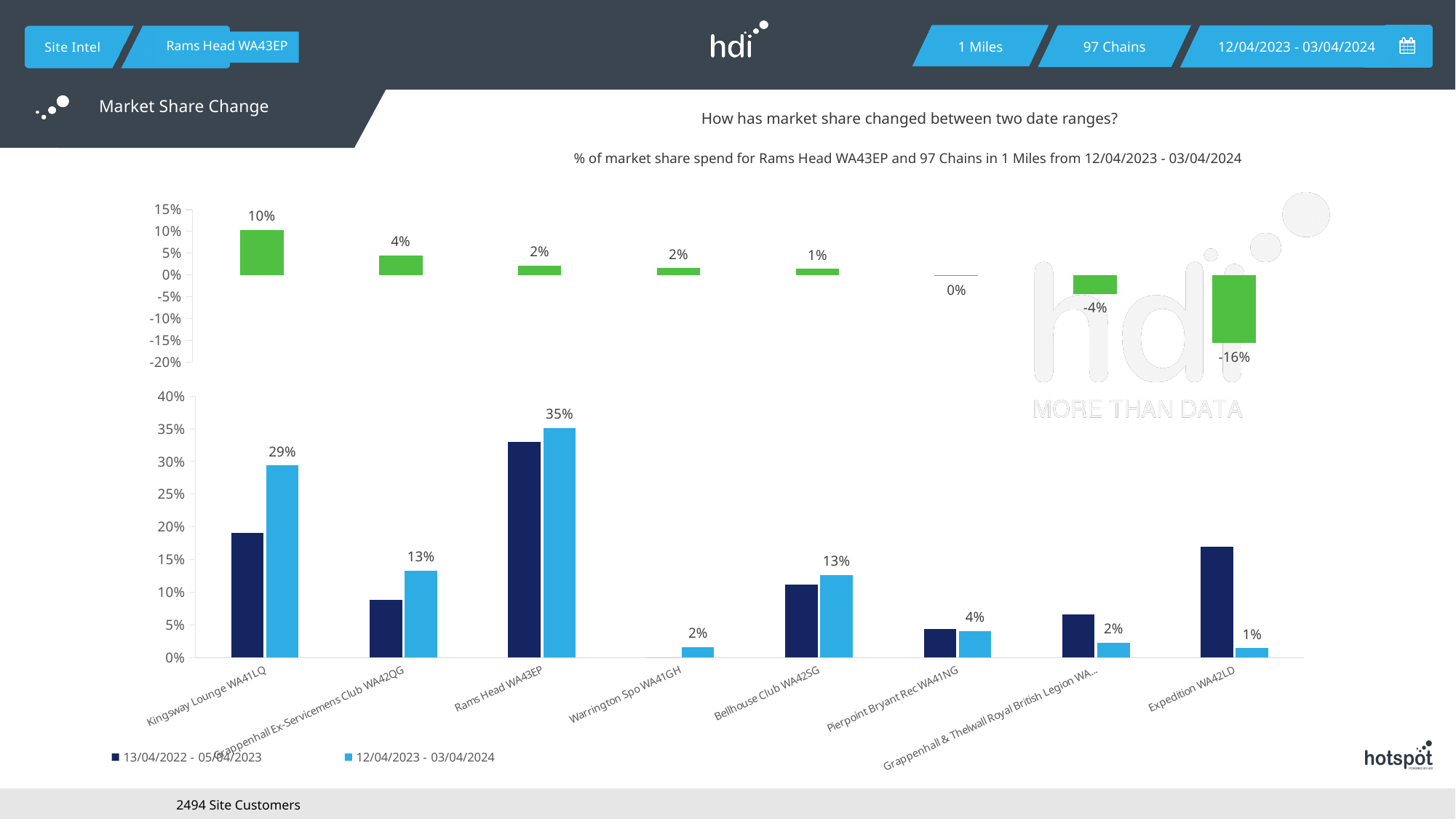
In the bottom chart, how many series does the legend list? 2 In the bottom chart, what is the market share for Kingsway Lounge WA41LQ in the 12/04/2023 - 03/04/2024 period? 29% In the top chart, what is the market share change for Kingsway Lounge WA41LQ? 10% In the top chart, which location has the largest market share change? Kingsway Lounge WA41LQ In the top chart, which location has the lowest market share change? Expedition WA42LD In the top chart, what is the difference between the market share change for Kingsway Lounge WA41LQ and Grappenhall Ex-Servicemens Club WA42QG? 6% How many locations are shown on the x axis of the bottom chart? 8 In the bottom chart, what is the market share for Rams Head WA43EP in the 12/04/2023 - 03/04/2024 period? 35% In the top chart, what is the market share change for Expedition WA42LD? -16% In the bottom chart, which location has the highest market share in the 12/04/2023 - 03/04/2024 period? Rams Head WA43EP What type of chart is the bottom chart? Bar chart In the bottom chart, is the 13/04/2022 - 05/04/2023 value for Expedition WA42LD greater or less than 15%? greater